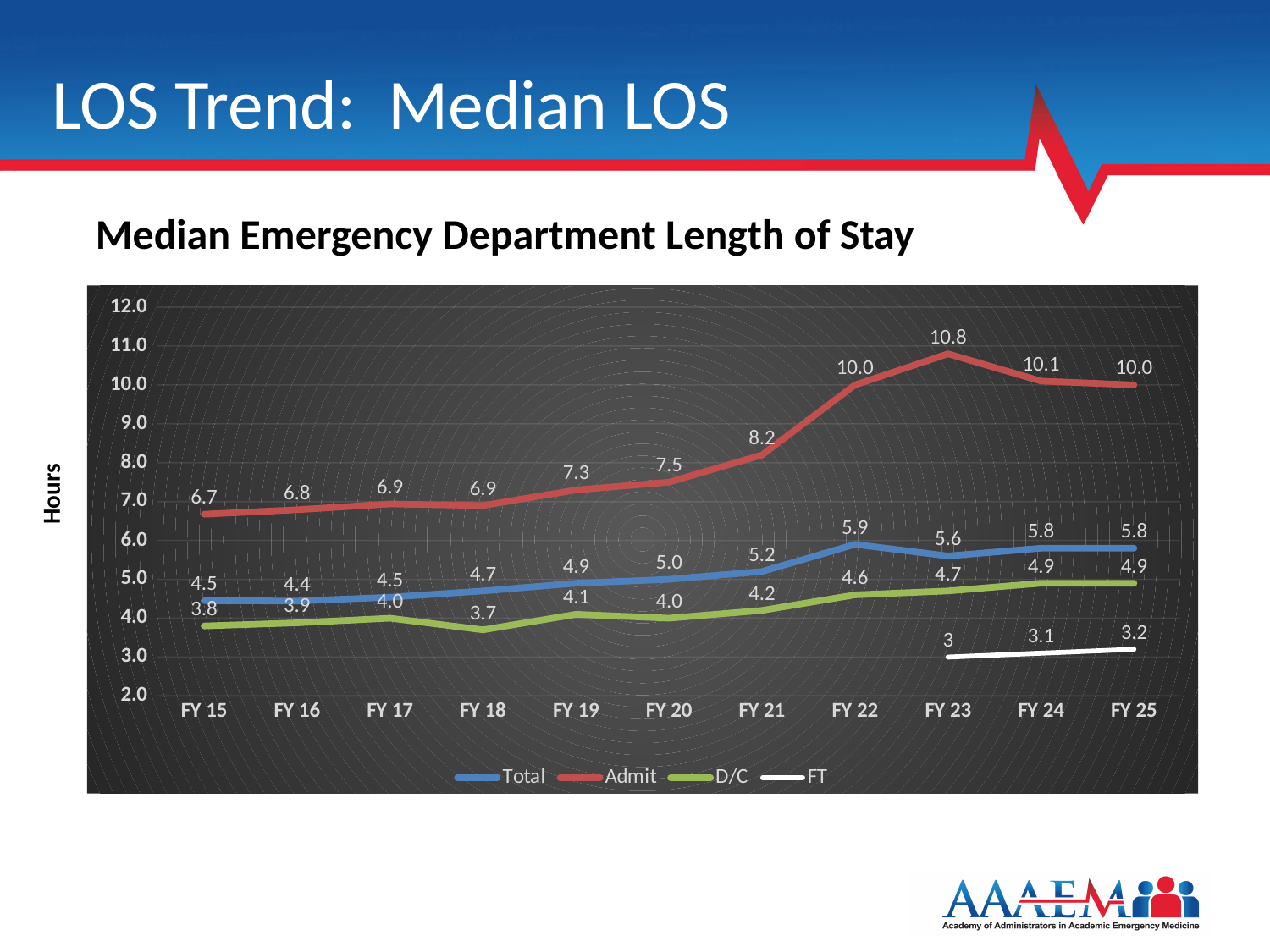
In which fiscal year is the D/C series lowest? FY 18 What is the Admit value for FY 23? 10.8 Which is larger, the Total value in FY 22 or the Total value in FY 23? FY 22 What is the Total value for FY 15? 4.5 What is the difference between the Admit value and the Total value in FY 25? 4.2 In which fiscal year is the Admit series highest? FY 23 What is the D/C value for FY 18? 3.7 What is the label on the vertical axis? Hours What is the FT value for FY 25? 3.2 How many fiscal years are shown on the x axis? 11 How many series does the legend list? 4 What kind of chart is shown? Line chart